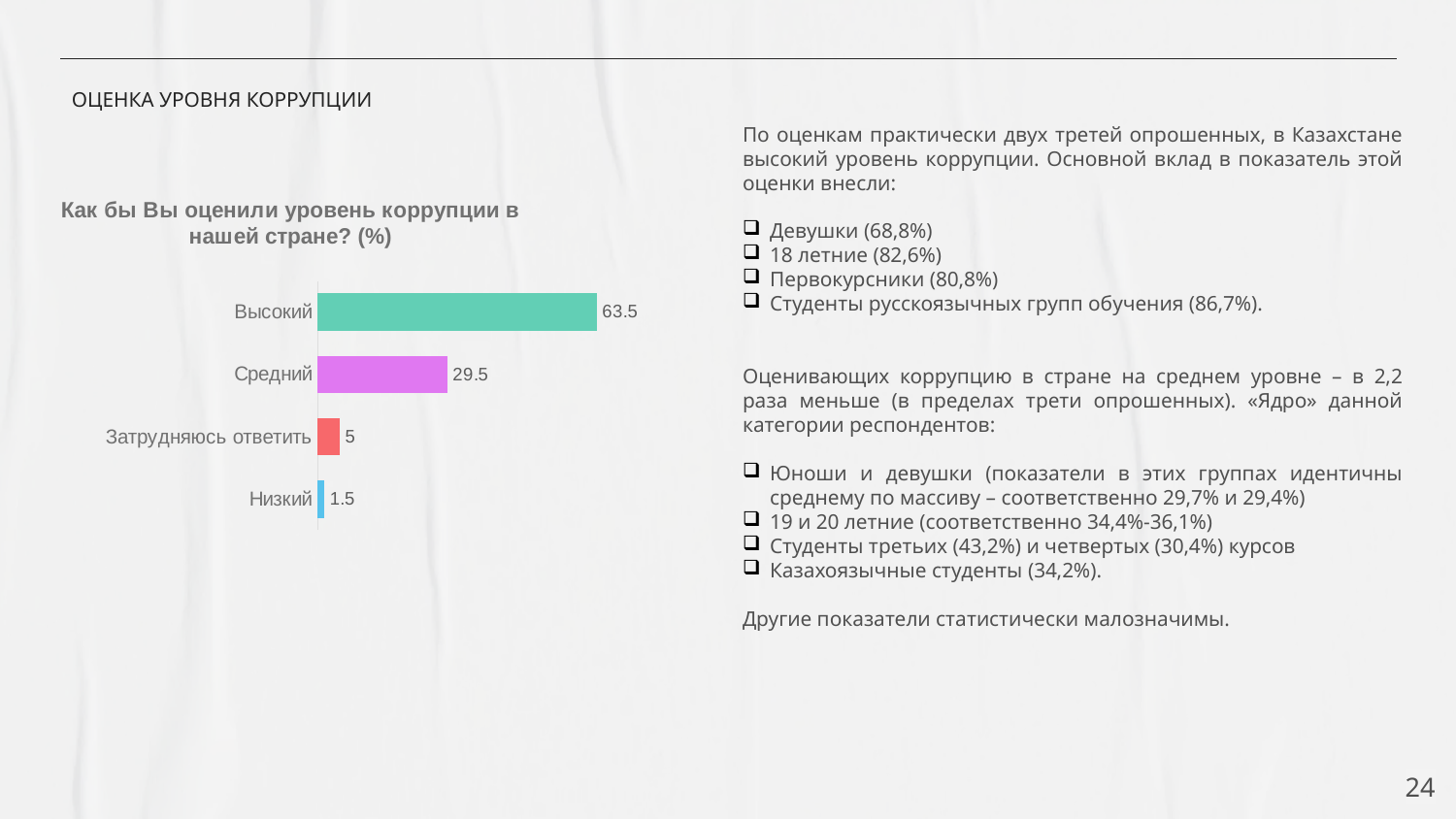
What is the value for Затрудняюсь ответить? 5 Which category has the highest value? Высокий What is the value for Средний? 29.5 Which is larger, the value for Средний or the value for Затрудняюсь ответить? Средний What kind of chart is shown on the slide? Bar chart What is the difference between the values for Затрудняюсь ответить and Низкий? 3.5 What is the title of the chart? Как бы Вы оценили уровень коррупции в нашей стране? (%) How many categories are shown in the chart? 4 Which category has the lowest value? Низкий What is the value for Высокий? 63.5 What is the difference between the values for Высокий and Средний? 34 What is the value for Низкий? 1.5